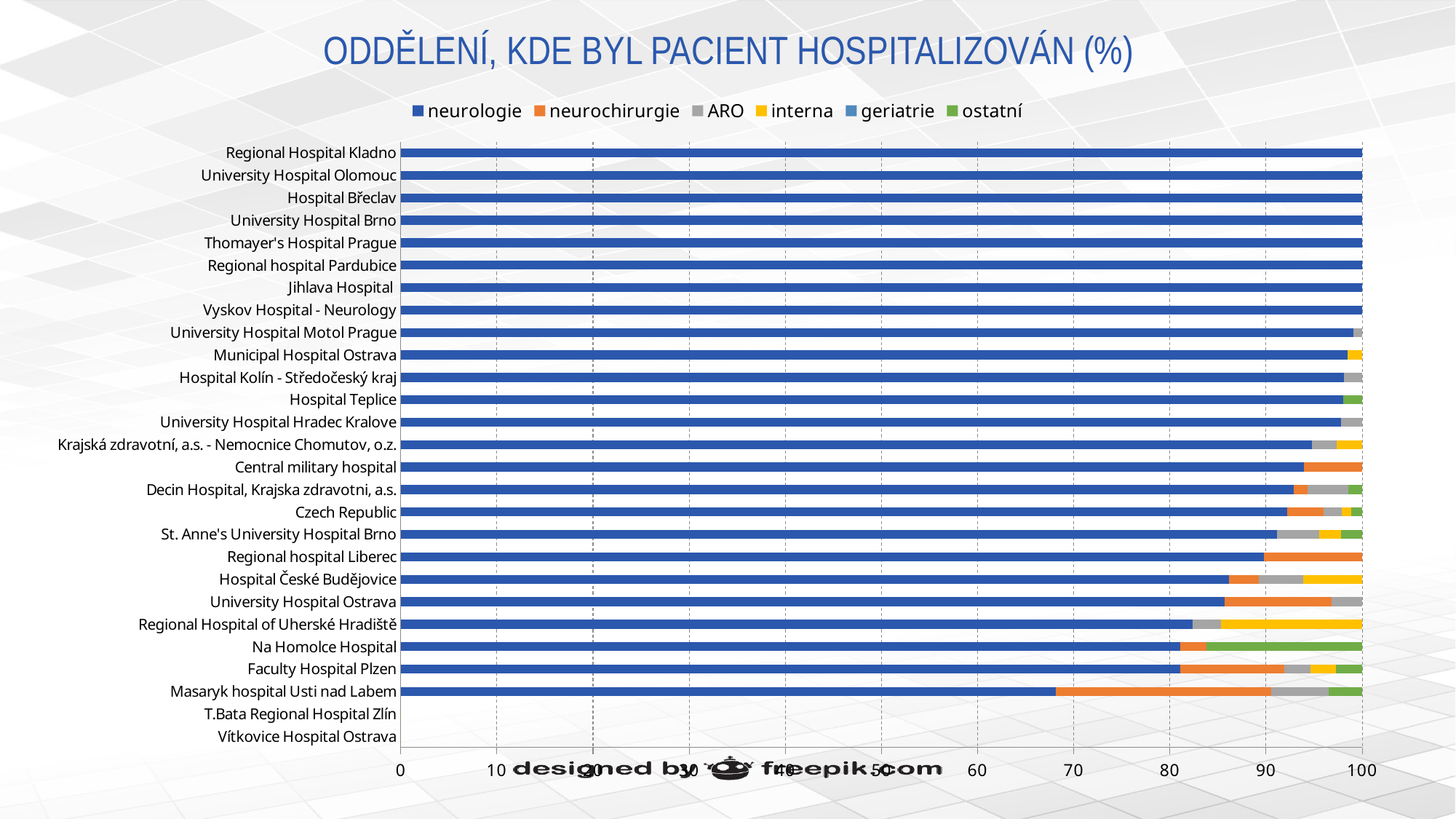
Is the neurologie value for Faculty Hospital Plzen greater or less than 80? greater What colour represents the neurochirurgie series in the legend? orange How many series does the legend list? 6 Which has the larger interna share, Regional Hospital of Uherské Hradiště or Municipal Hospital Ostrava? Regional Hospital of Uherské Hradiště Which has the larger ostatní share, Na Homolce Hospital or Hospital Teplice? Na Homolce Hospital Is the neurologie value for Masaryk hospital Usti nad Labem greater or less than 70? less What is the title of the chart? ODDĚLENÍ, KDE BYL PACIENT HOSPITALIZOVÁN (%) Among hospitals with a plotted bar, which has the lowest neurologie share? Masaryk hospital Usti nad Labem Is the neurologie value for Regional hospital Liberec greater or less than 80? greater What kind of chart is shown on the slide? stacked bar chart Which has the larger neurochirurgie share, Masaryk hospital Usti nad Labem or Central military hospital? Masaryk hospital Usti nad Labem How many hospital categories are listed on the vertical axis? 27